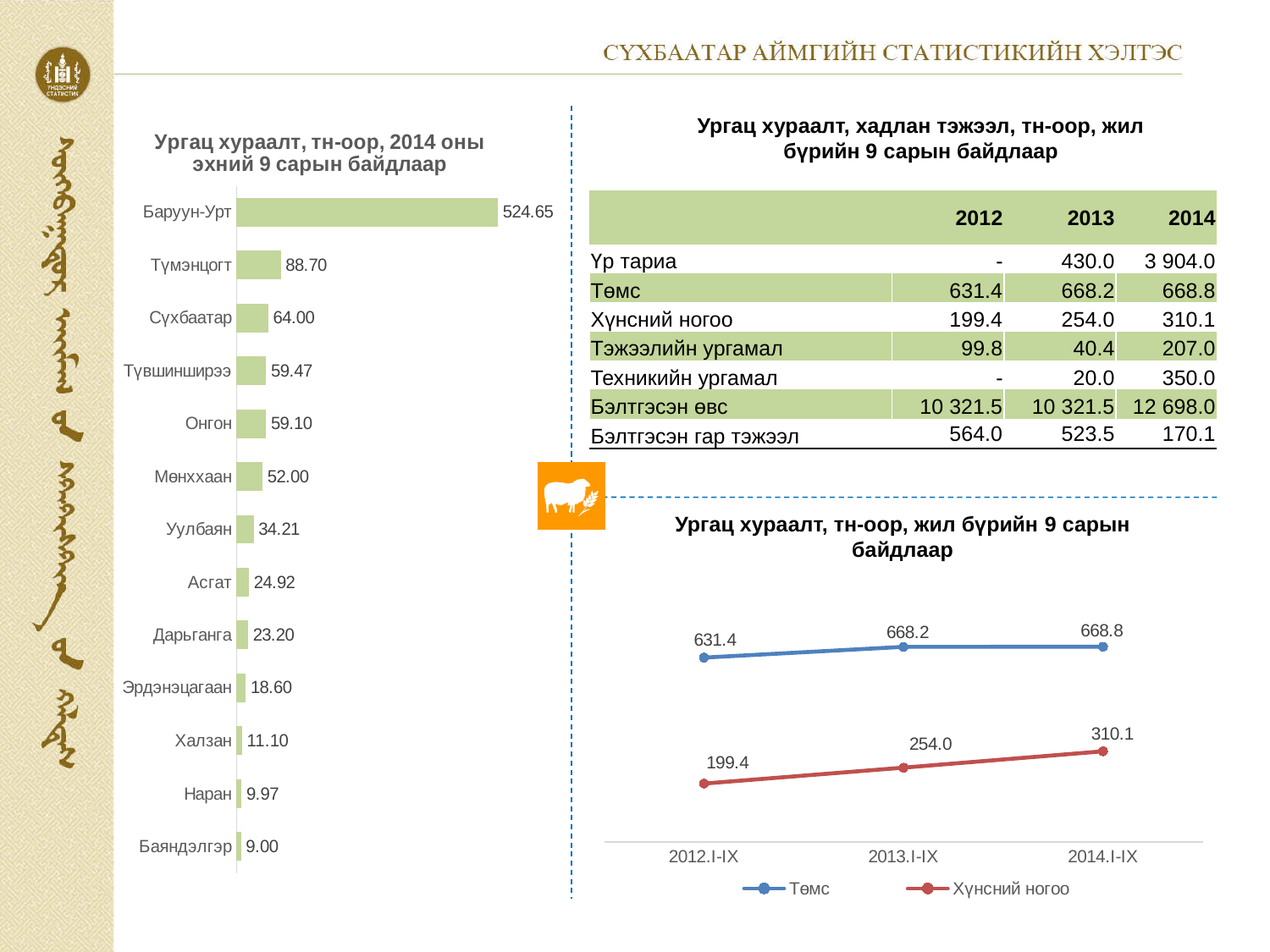
In the bar chart 'Ургац хураалт, тн-оор, 2014 оны эхний 9 сарын байдлаар', which category has the highest value? Баруун-Урт In the line chart 'Ургац хураалт, тн-оор, жил бүрийн 9 сарын байдлаар', does the Хүнсний ногоо series rise or fall from 2012.I-IX to 2014.I-IX? Rise In the bar chart 'Ургац хураалт, тн-оор, 2014 оны эхний 9 сарын байдлаар', what is the difference between Түмэнцогт and Сүхбаатар? 24.70 In the line chart 'Ургац хураалт, тн-оор, жил бүрийн 9 сарын байдлаар', what is the difference between Төмс and Хүнсний ногоо in 2014.I-IX? 358.7 What type of chart is the chart on the left of the slide? Bar chart How many series does the legend of the line chart 'Ургац хураалт, тн-оор, жил бүрийн 9 сарын байдлаар' list? 2 In the bar chart 'Ургац хураалт, тн-оор, 2014 оны эхний 9 сарын байдлаар', what is the value for Баруун-Урт? 524.65 In the bar chart 'Ургац хураалт, тн-оор, 2014 оны эхний 9 сарын байдлаар', which category has the lowest value? Баяндэлгэр In the line chart 'Ургац хураалт, тн-оор, жил бүрийн 9 сарын байдлаар', what is the value for Хүнсний ногоо in 2013.I-IX? 254.0 How many categories are shown in the bar chart 'Ургац хураалт, тн-оор, 2014 оны эхний 9 сарын байдлаар'? 13 In the bar chart 'Ургац хураалт, тн-оор, 2014 оны эхний 9 сарын байдлаар', which is larger, Уулбаян or Асгат? Уулбаян In the bar chart 'Ургац хураалт, тн-оор, 2014 оны эхний 9 сарын байдлаар', what is the value for Онгон? 59.10